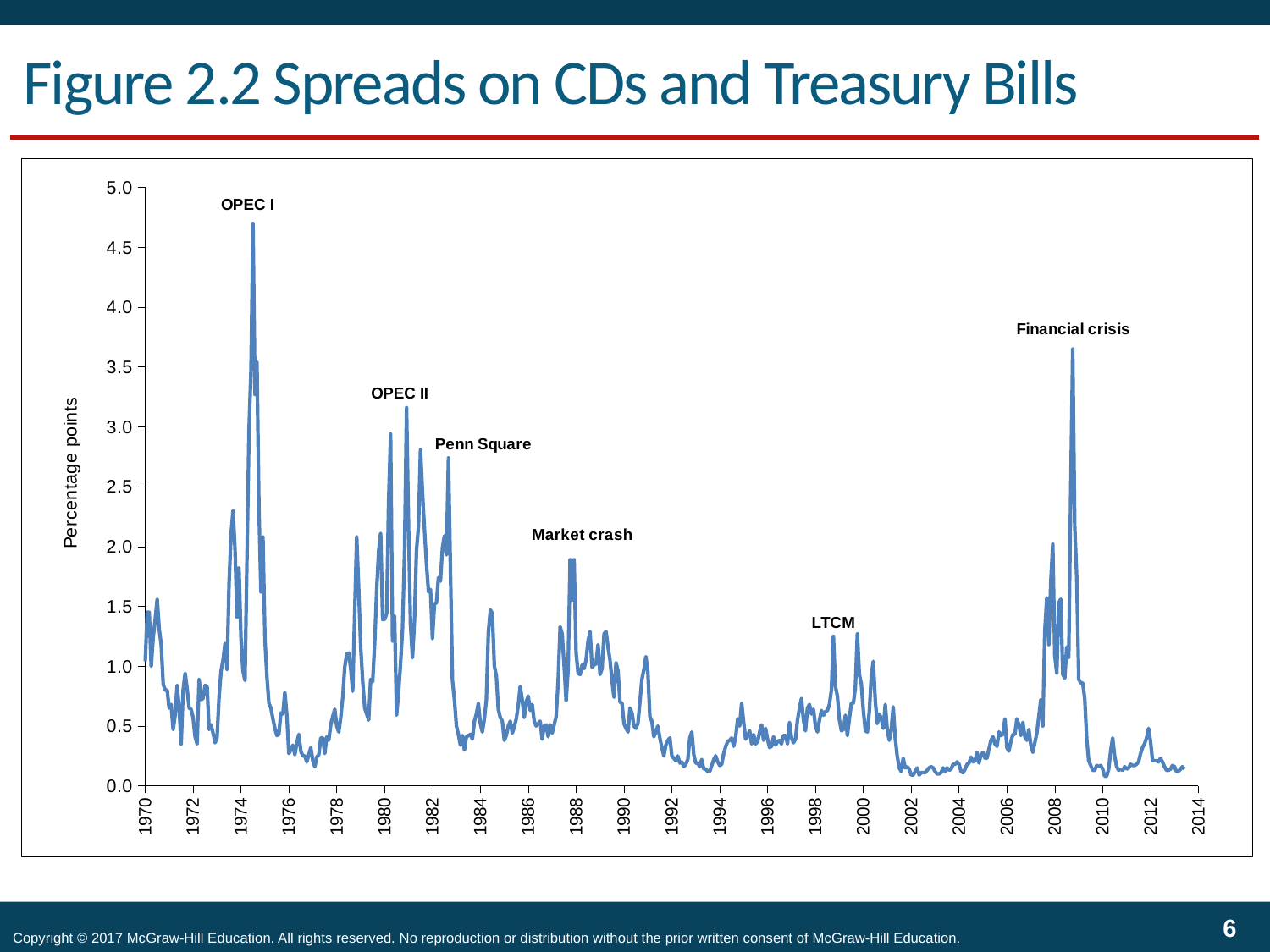
Which peak is higher, the one labelled OPEC I or the one labelled Financial crisis? OPEC I Is the peak value at Penn Square greater or less than 2.5 percentage points? greater Is the peak value at LTCM greater or less than 1.5 percentage points? less Among the annotated events, which one corresponds to the lowest peak in the spread? LTCM Which annotated event corresponds to the highest peak in the spread? OPEC I What is the label on the vertical axis of the chart? Percentage points Which peak is higher, the one labelled OPEC II or the one labelled Market crash? OPEC II What is the title of the chart on the slide? Figure 2.2 Spreads on CDs and Treasury Bills Is the peak value at the Financial crisis greater or less than 3.0 percentage points? greater How many annotated events are labelled on the chart? 6 What kind of chart is shown on the slide? line chart